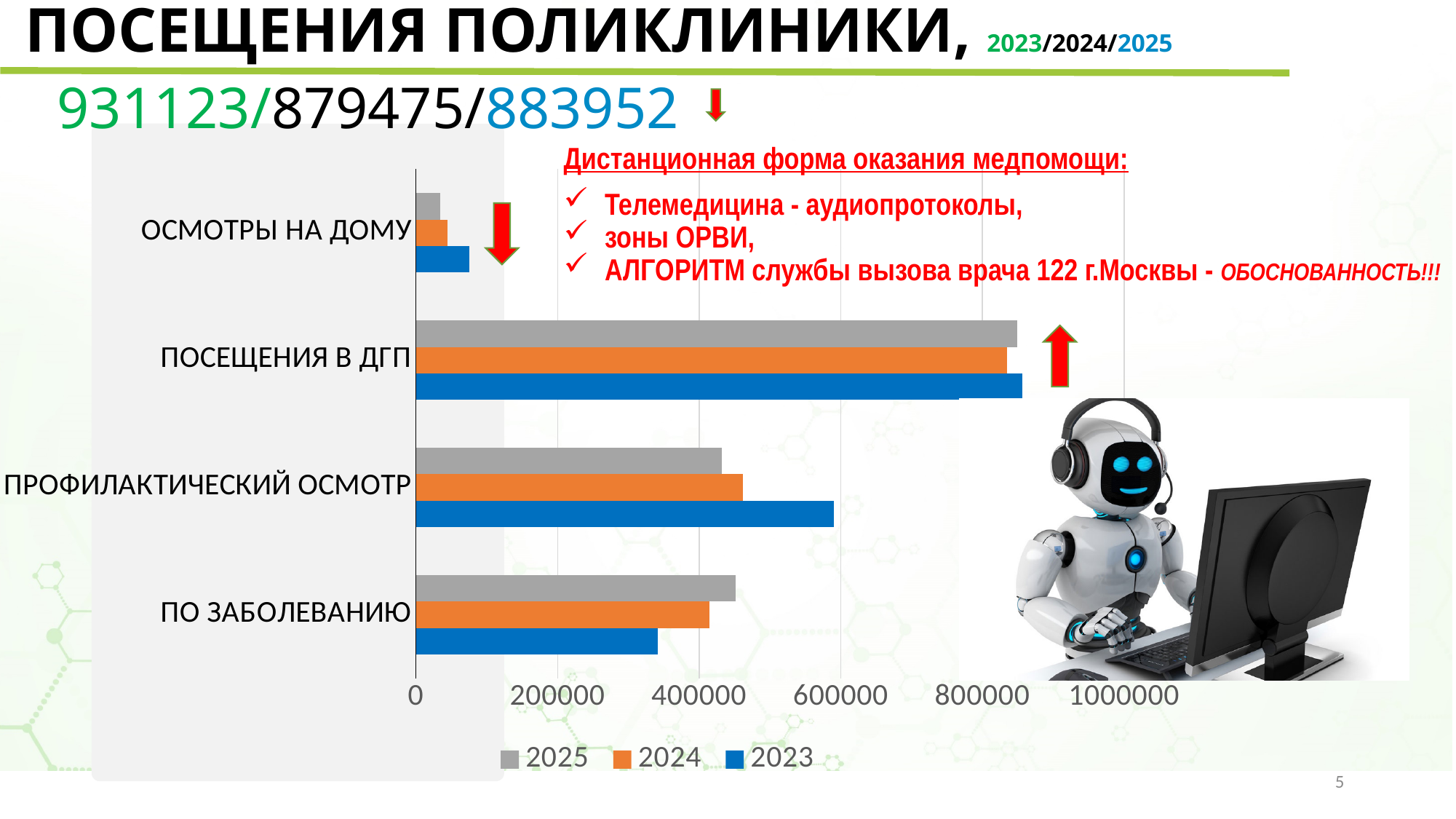
How many series does the chart legend list? 3 Is the 2023 value for ПО ЗАБОЛЕВАНИЮ greater or less than 400000? less Which colour represents the 2024 series in the chart legend? orange What kind of chart is shown on the slide? bar chart Is the 2023 value for ПОСЕЩЕНИЯ В ДГП greater or less than 800000? greater How many categories are shown on the chart's vertical axis? 4 Which category has the highest values across all three years? ПОСЕЩЕНИЯ В ДГП Is the 2025 value for ОСМОТРЫ НА ДОМУ greater or less than 200000? less For ПО ЗАБОЛЕВАНИЮ, which year has the larger value: 2023 or 2025? 2025 For ПРОФИЛАКТИЧЕСКИЙ ОСМОТР, which year has the larger value: 2023 or 2025? 2023 Which category has the lowest values across all three years? ОСМОТРЫ НА ДОМУ